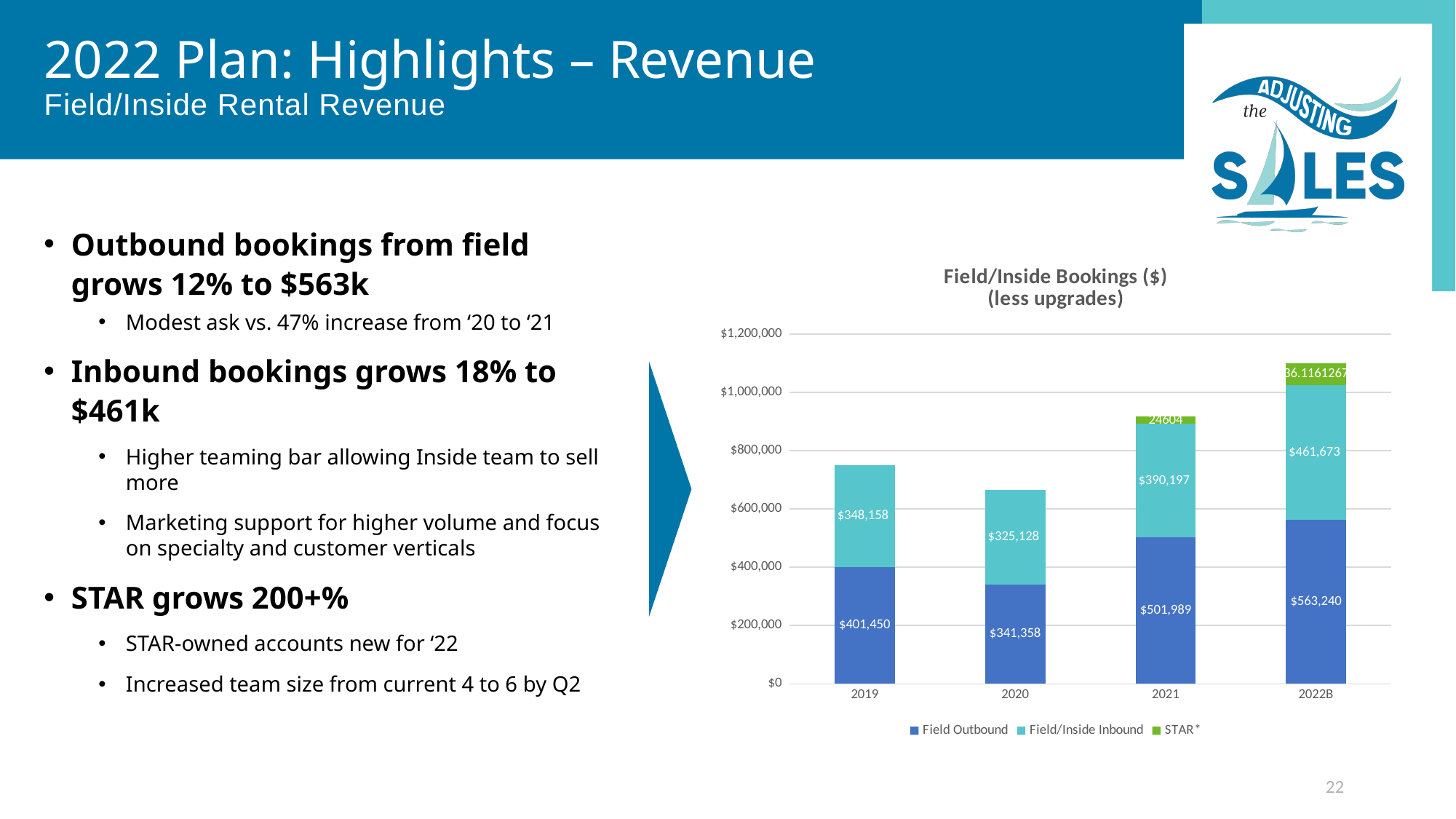
How many series does the legend list? 3 What is the title of the chart? Field/Inside Bookings ($) (less upgrades) Which is larger: Field/Inside Inbound in 2020 or Field/Inside Inbound in 2021? 2021 What is the STAR* value for 2021? 24604 Which year has the highest Field/Inside Inbound value? 2022B What type of chart is shown on the slide? Stacked bar chart What is the Field/Inside Inbound value for 2022B? $461,673 What is the total of the stacked bar for 2019? $749,608 What is the difference between the Field Outbound values for 2022B and 2021? $61,251 Which year has the lowest Field Outbound value? 2020 What is the Field Outbound value for 2019? $401,450 Is the total stacked bar for 2020 greater or less than $800,000? less